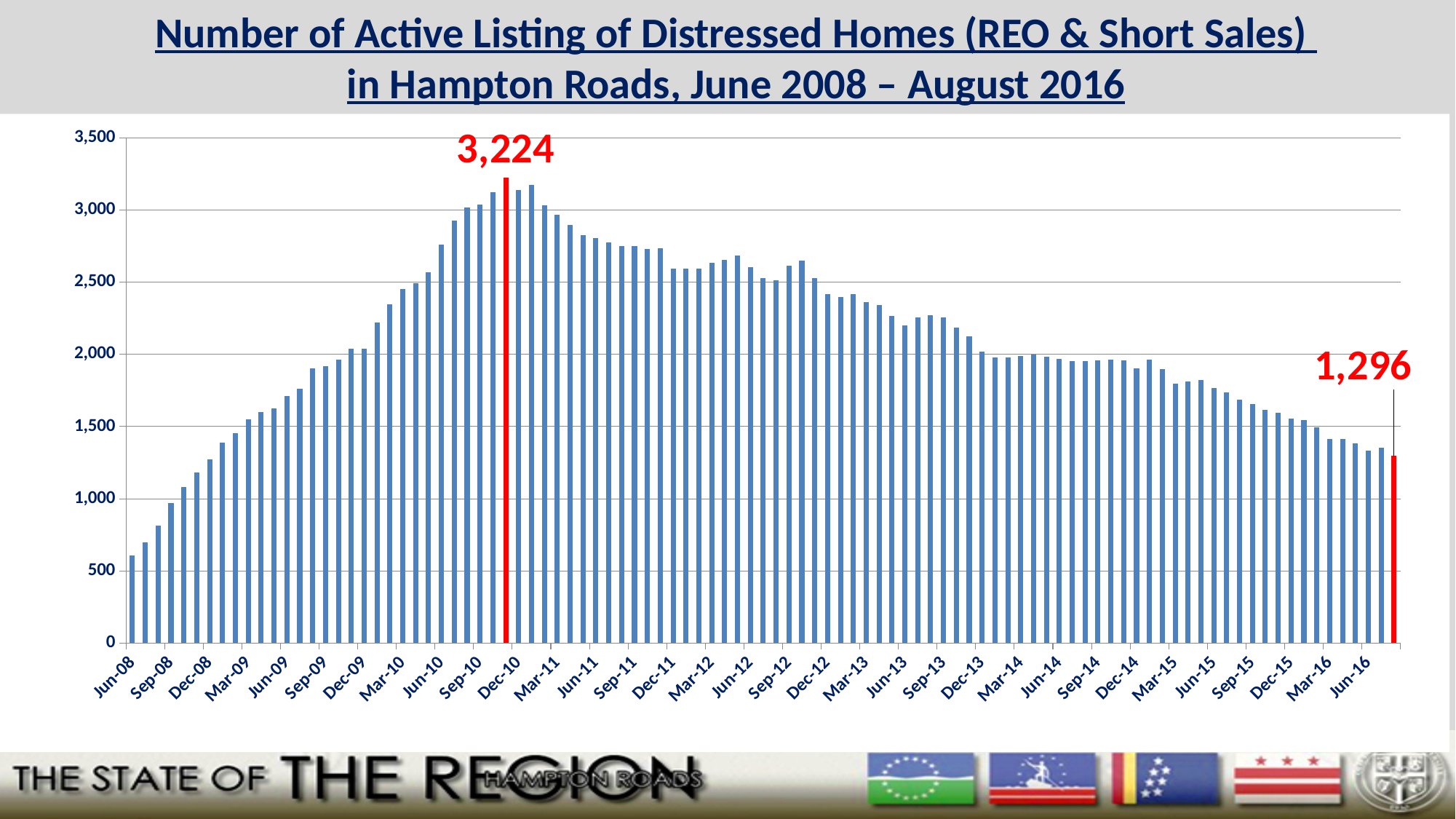
What kind of chart is shown on the slide? bar chart What colour are the two highlighted bars with value labels? red Which is larger, the value for Jun-08 or the value for Jun-16? Jun-16 What is the difference between the labeled peak value and the labeled August 2016 value? 1,928 What is the value labeled for the final bar (August 2016)? 1,296 What is the peak value labeled on the chart? 3,224 Do the values rise or fall from Dec-10 to Aug-16? fall Is the value for Jun-08 greater or less than 1,000? less Is the value for Dec-15 greater or less than 2,000? less Is the value for Mar-10 greater or less than 2,000? greater Which month has the lowest number of active distressed listings? Jun-08